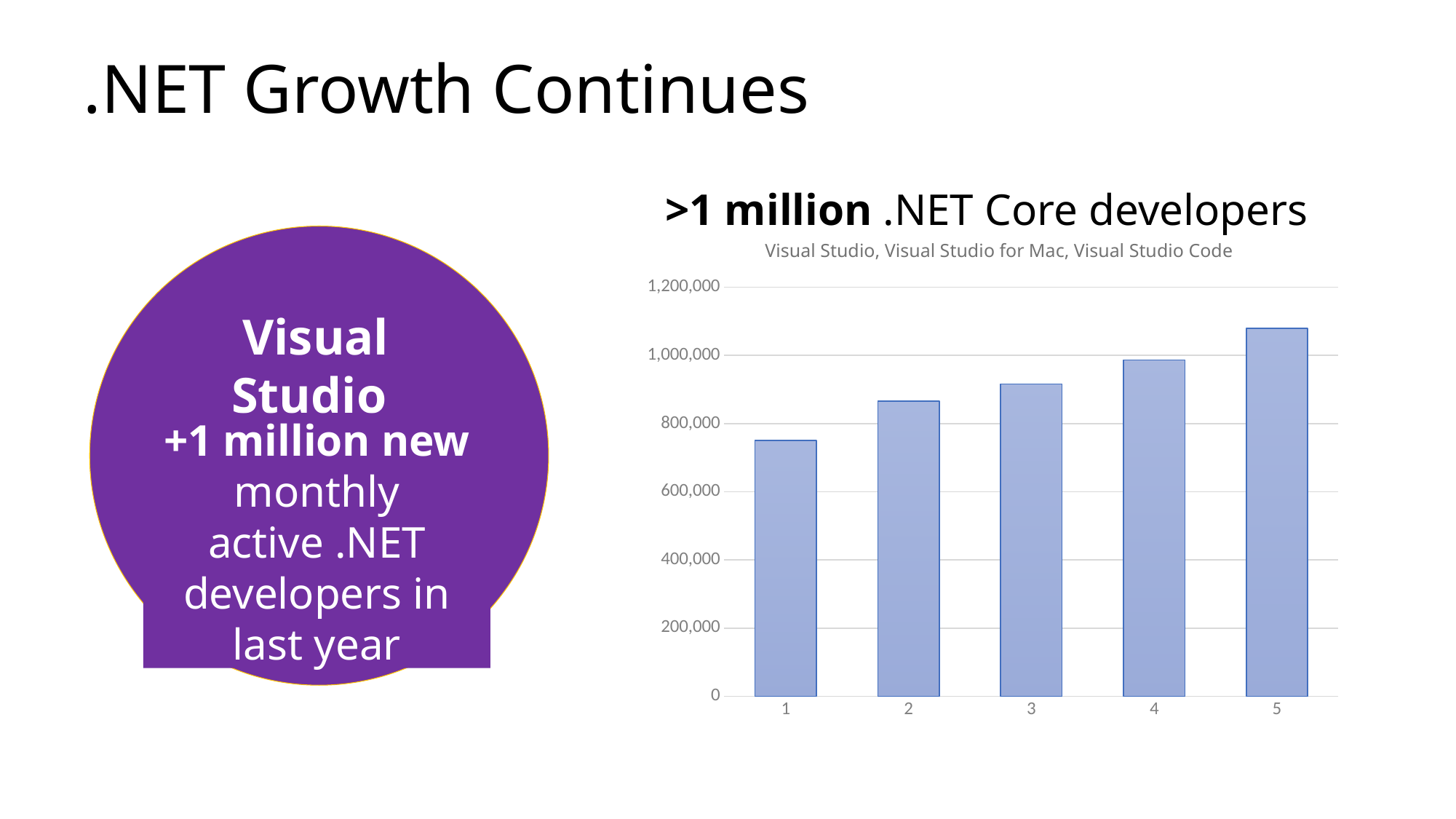
Is the value for category 3 greater or less than 1,000,000? less How many bars are plotted in the chart? 5 Which category has the highest bar in the chart? 5 What is the highest value shown on the chart's vertical axis? 1,200,000 Is the value for category 5 greater or less than 1,000,000? greater What is the title of the chart? >1 million .NET Core developers What kind of chart is shown on the slide? bar chart Is the value for category 2 greater or less than 800,000? greater Do the values rise or fall from category 1 to category 5? rise Which is larger, the value for category 5 or the value for category 1? category 5 Which category has the lowest bar in the chart? 1